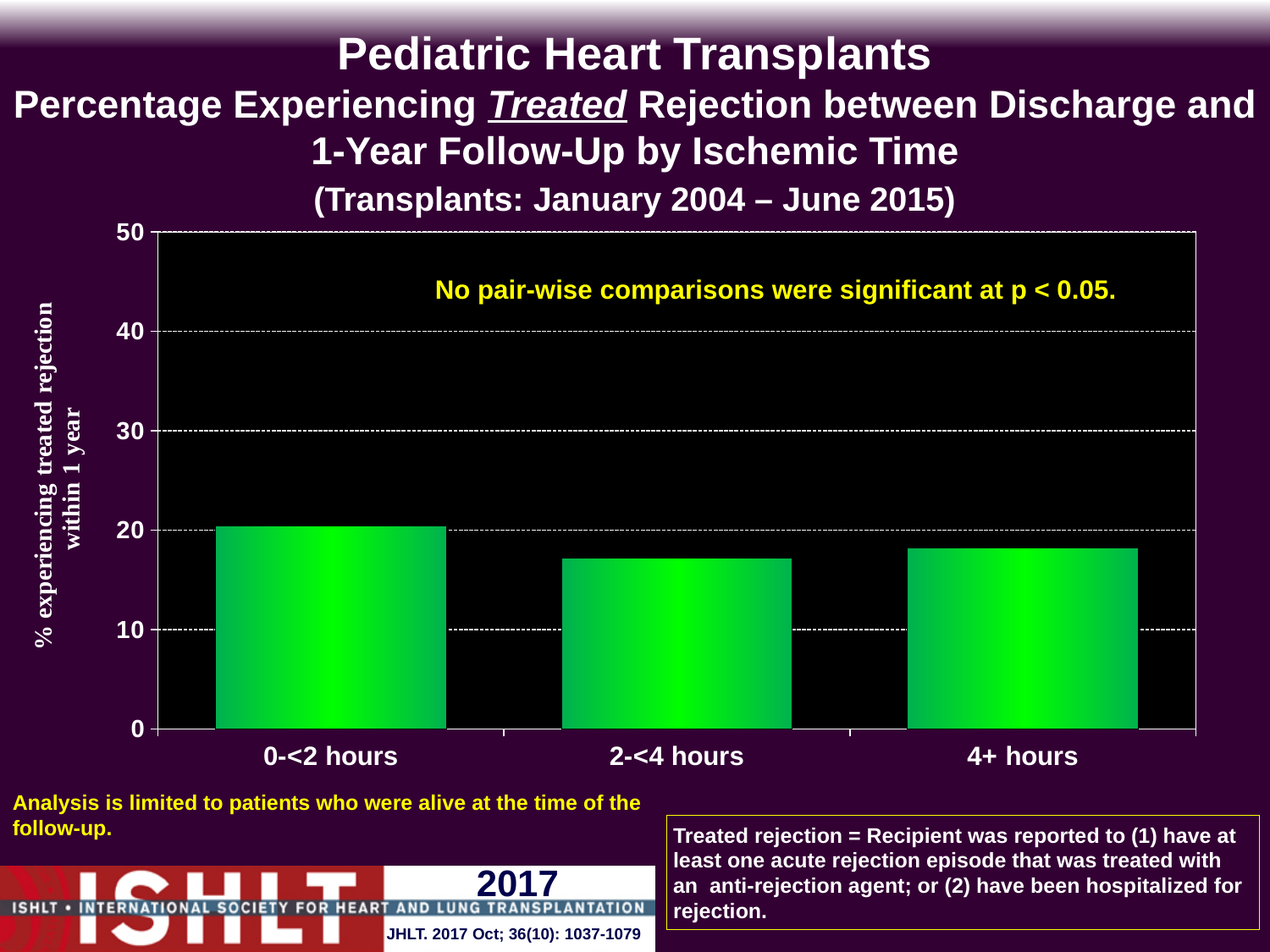
Is the value for 0-<2 hours greater or less than 30? less Which ischemic time category has the highest percentage experiencing treated rejection? 0-<2 hours What does the annotation inside the chart say about pair-wise comparisons? No pair-wise comparisons were significant at p < 0.05. Which is larger, the value for 0-<2 hours or the value for 4+ hours? 0-<2 hours Is the value for 2-<4 hours greater or less than 20? less What kind of chart is shown on the slide? bar chart Is the value for 4+ hours greater or less than 10? greater What is the label on the y axis of the chart? % experiencing treated rejection within 1 year How many ischemic time categories are shown on the x axis? 3 Which is larger, the value for 0-<2 hours or the value for 2-<4 hours? 0-<2 hours